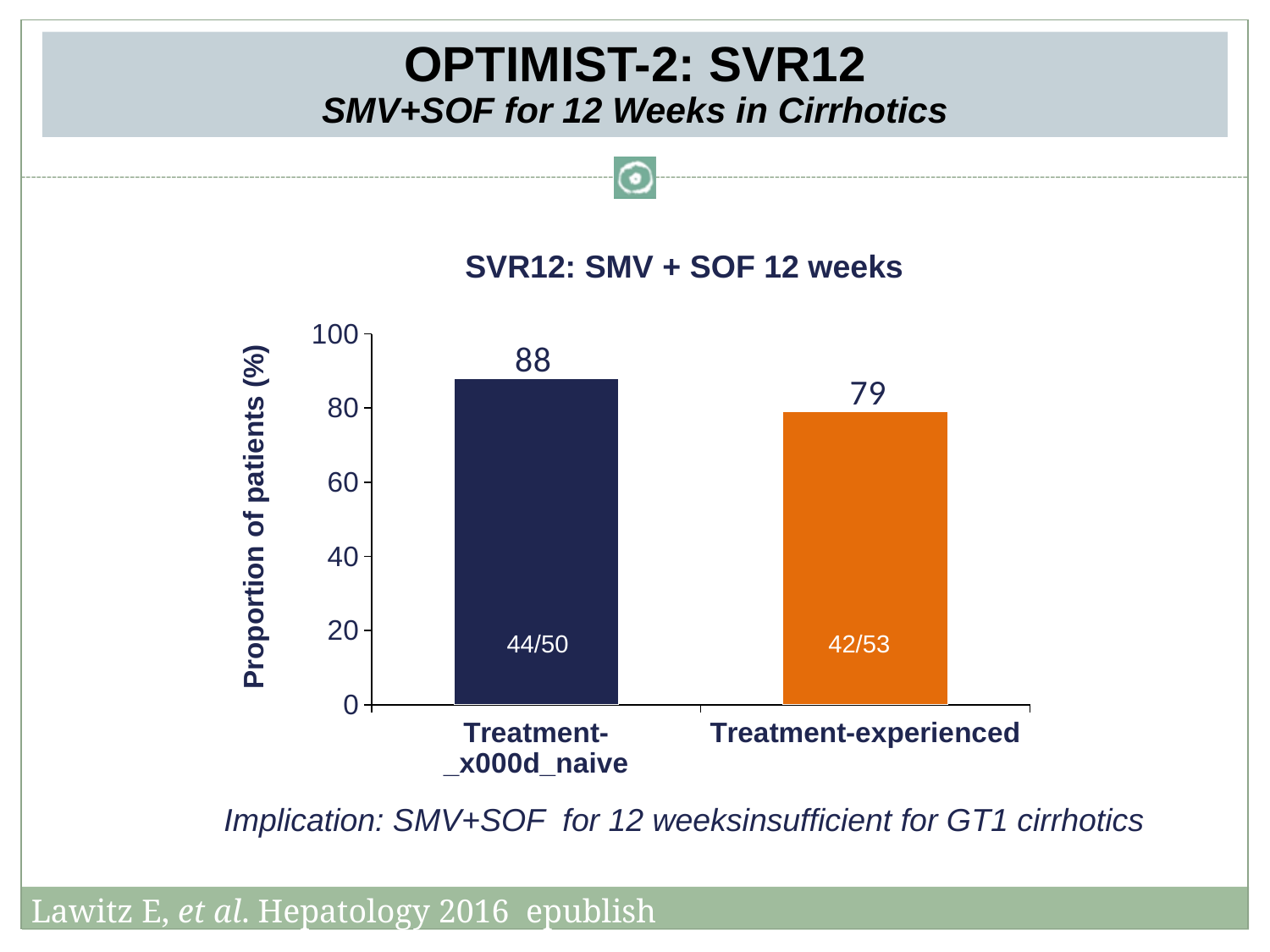
Which category has the highest SVR12 value? Treatment-naive What is the SVR12 value for Treatment-experienced patients? 79 What is the title of the chart? SVR12: SMV + SOF 12 weeks How many categories are shown on the x axis? 2 What fraction of patients is printed inside the Treatment-naive bar? 44/50 Which category has the lowest SVR12 value? Treatment-experienced Is the value for Treatment-experienced greater or less than 80? less What kind of chart is shown on the slide? bar chart Which is larger, the value for Treatment-naive or for Treatment-experienced? Treatment-naive What is the difference between the Treatment-naive and Treatment-experienced SVR12 values? 9 What is the SVR12 value for Treatment-naive patients? 88 What fraction of patients is printed inside the Treatment-experienced bar? 42/53